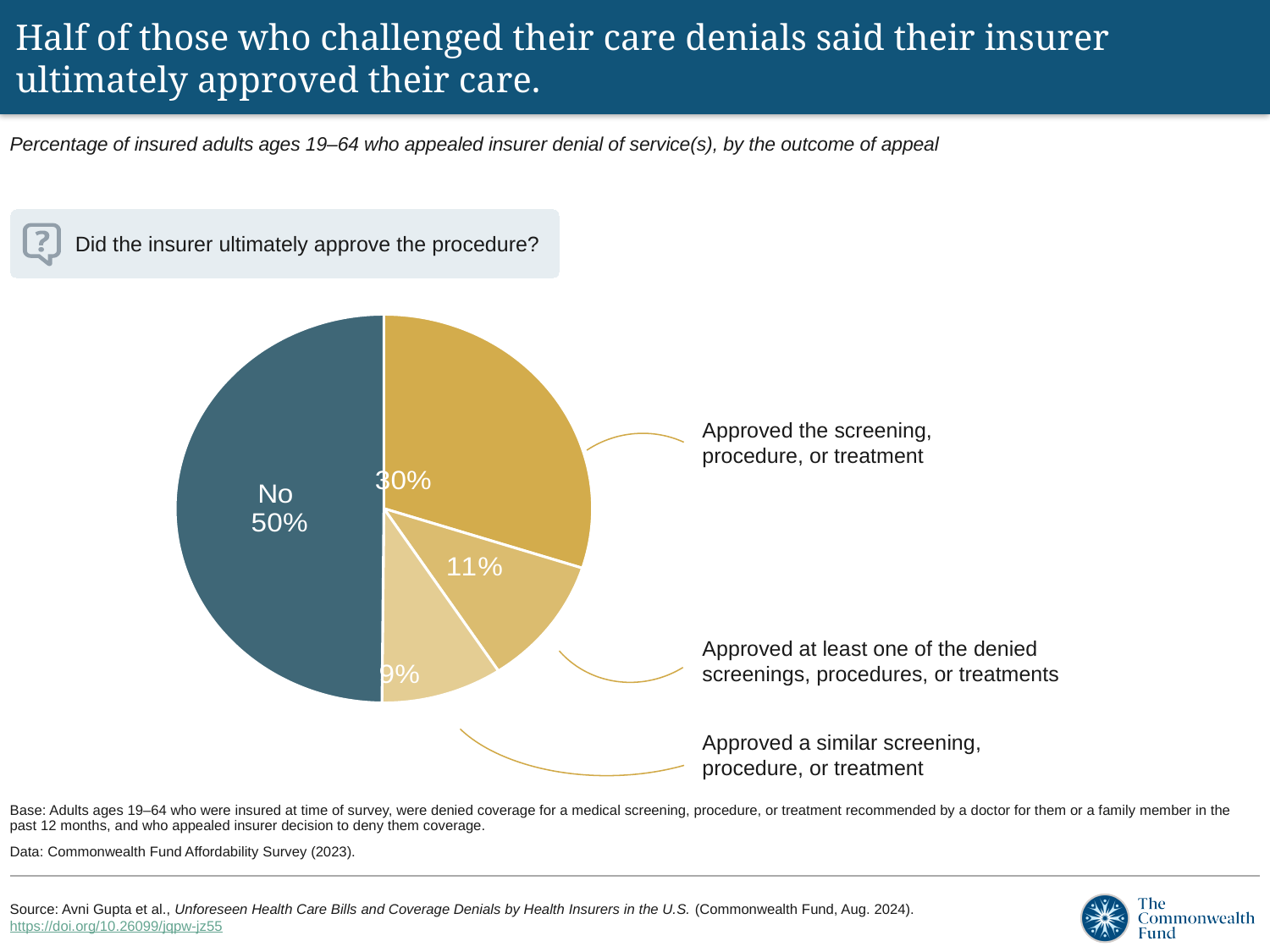
What percentage of respondents said the insurer did not ultimately approve the procedure ("No")? 50% Which is larger: the share for "Approved at least one of the denied screenings, procedures, or treatments" or the share for "Approved a similar screening, procedure, or treatment"? Approved at least one of the denied screenings, procedures, or treatments What percentage said the insurer approved the screening, procedure, or treatment? 30% What percentage said the insurer approved a similar screening, procedure, or treatment? 9% What is the combined percentage of all the "approved" outcomes (30%, 11%, and 9%)? 50% How many slices does the pie chart have? 4 What percentage said the insurer approved at least one of the denied screenings, procedures, or treatments? 11% What kind of chart is shown on the slide? Pie chart Which outcome has the smallest share of the pie? Approved a similar screening, procedure, or treatment What is the difference in percentage points between "No" and "Approved the screening, procedure, or treatment"? 20 percentage points Which outcome has the largest share of the pie? No What question is posed in the box above the pie chart? Did the insurer ultimately approve the procedure?